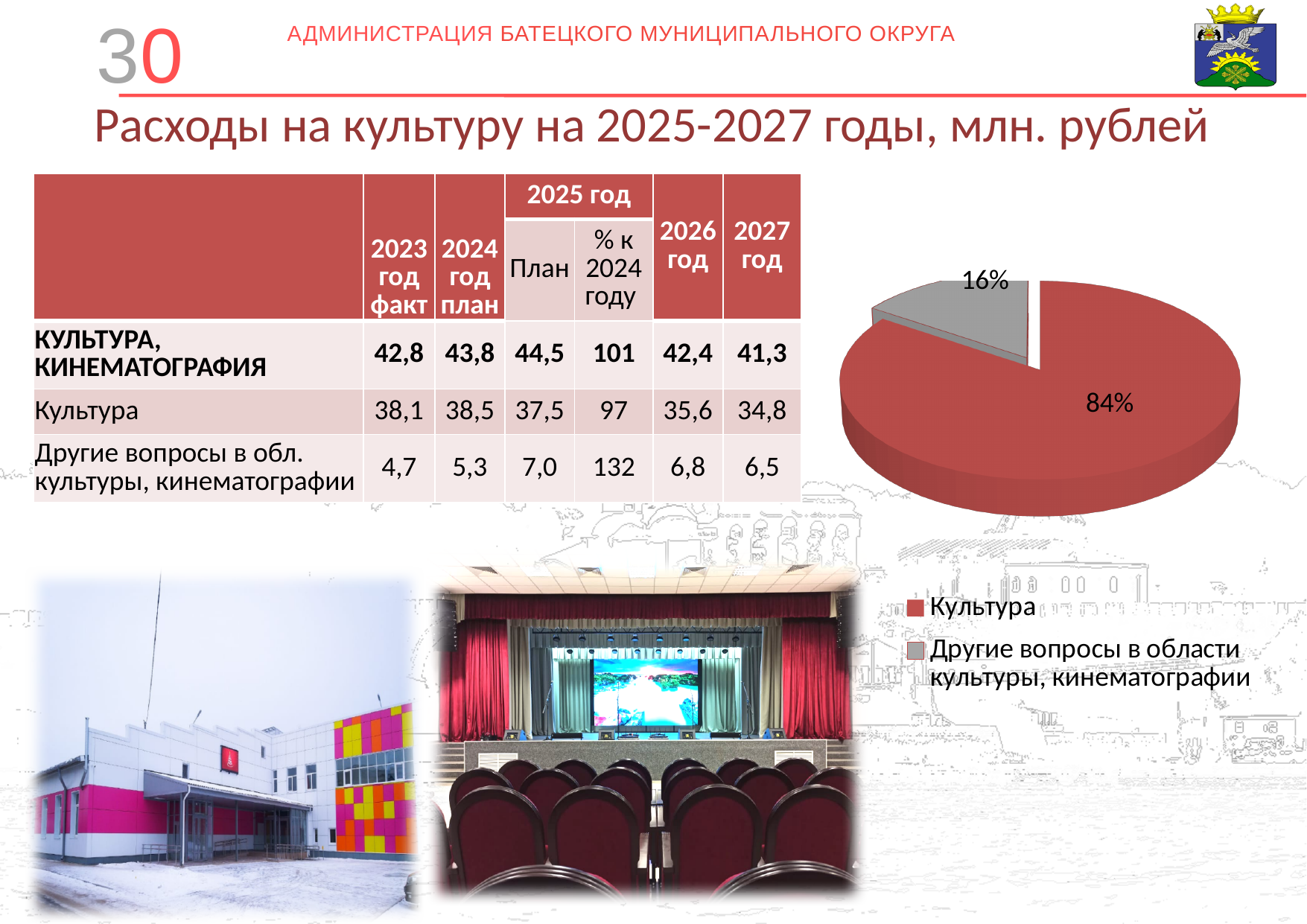
Which slice of the pie chart is the smallest? Другие вопросы в области культуры, кинематографии What colour is the Другие вопросы в области культуры, кинематографии slice in the pie chart? grey What is the difference in percentage points between the Культура slice and the Другие вопросы в области культуры, кинематографии slice? 68 What kind of chart is shown on the slide? pie chart How many slices does the pie chart have? 2 What colour is the Культура slice in the pie chart? red Which slice of the pie chart is the largest? Культура How many entries does the pie chart legend list? 2 Which is larger in the pie chart: Культура or Другие вопросы в области культуры, кинематографии? Культура What share of the pie chart does Культура take? 84% What share of the pie chart does Другие вопросы в области культуры, кинематографии take? 16%